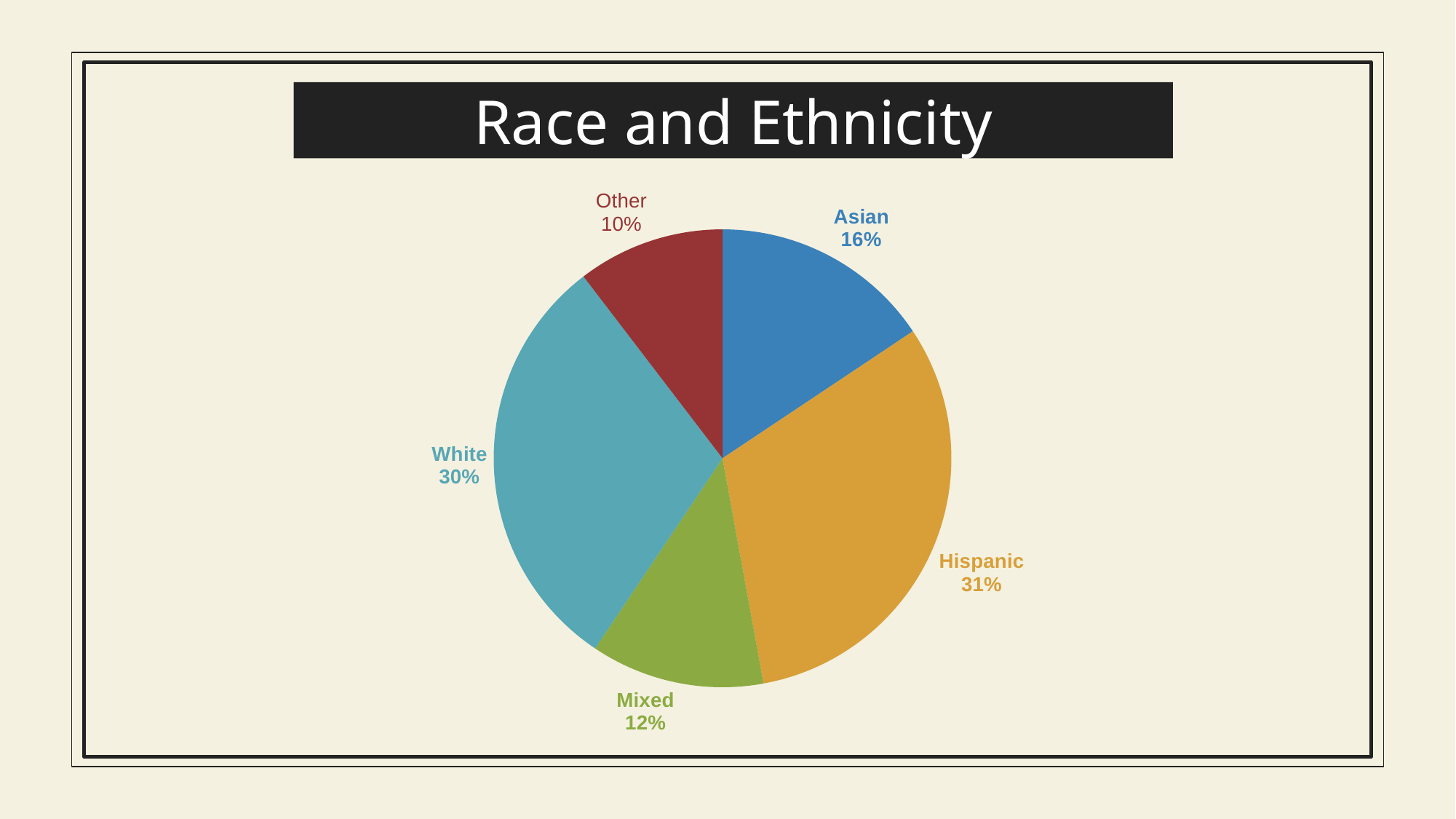
What percentage of the pie is Other? 10% What is the title of the chart? Race and Ethnicity What percentage of the pie is Mixed? 12% What type of chart is shown on the slide? pie chart What percentage of the pie is White? 30% What is the difference in percentage points between the White and Mixed slices? 18 What percentage of the pie is Asian? 16% How many slices does the pie chart have? 5 Which is larger, the Asian slice or the Other slice? Asian What is the difference in percentage points between the Asian and Other slices? 6 What percentage of the pie is Hispanic? 31% Which category has the smallest share of the pie? Other